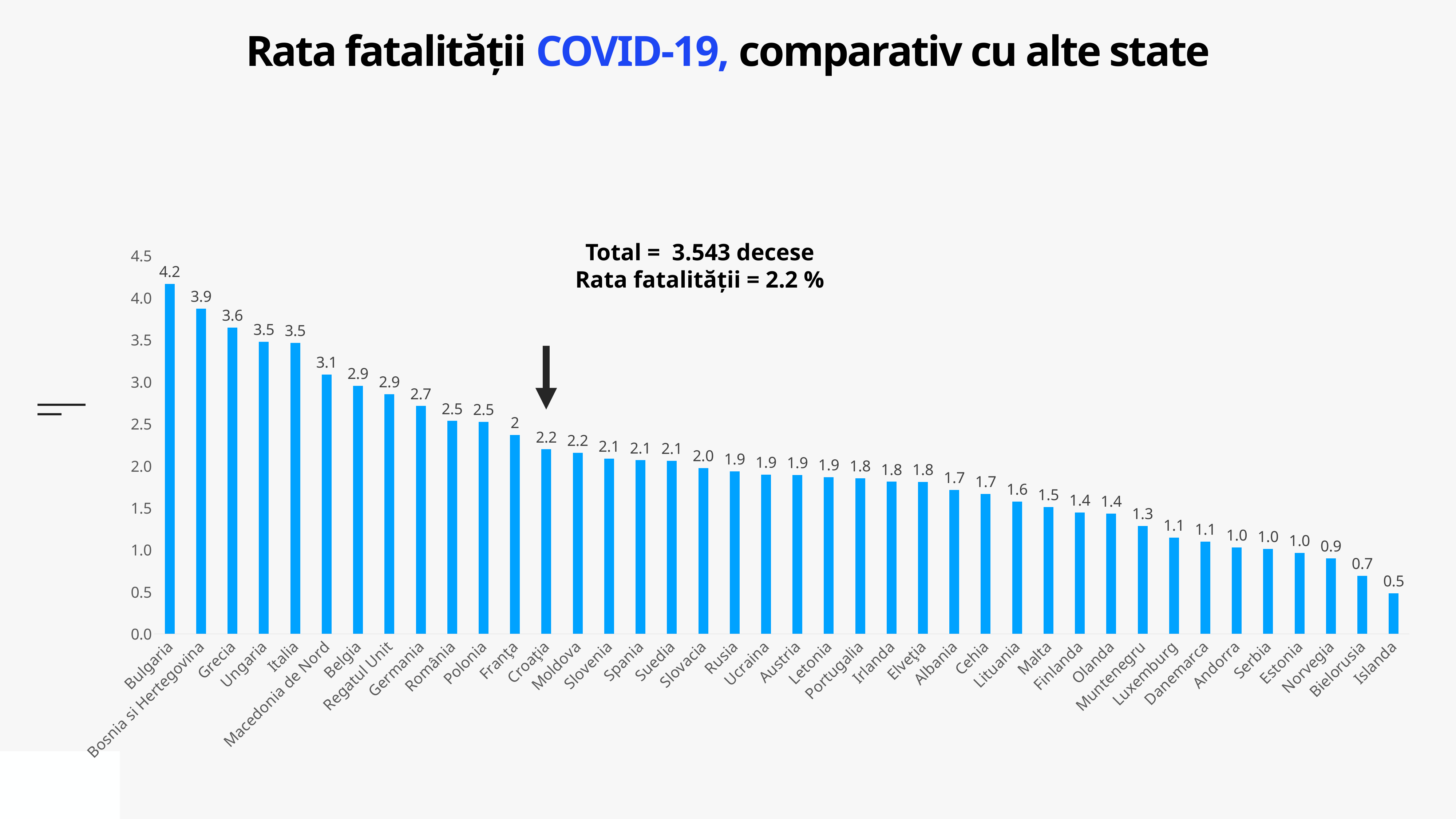
What is the value for Moldova? 2.2 Which country has the lowest value? Islanda Which is larger, the value for Grecia or the value for Belgia? Grecia What is the value for Bulgaria? 4.2 Do the values rise or fall from left to right along the x axis? Fall Which country has the highest value? Bulgaria What kind of chart is shown on the slide? Bar chart What is the value for Islanda? 0.5 What is the difference between the values for Bulgaria and Islanda? 3.7 How many countries are shown on the chart? 40 What total number of deaths is stated in the text above the chart? 3.543 decese What is the value for Germania? 2.7